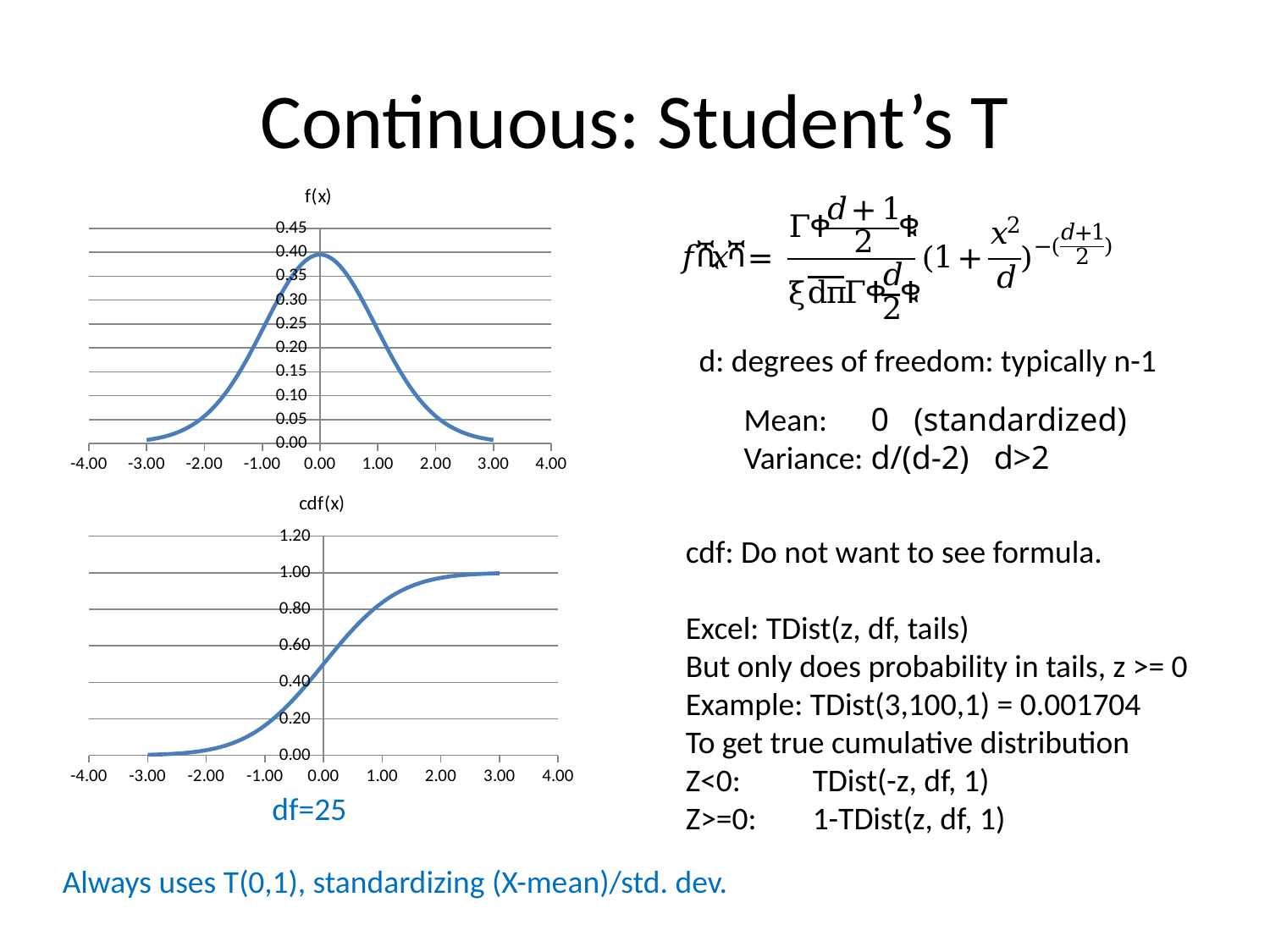
In the f(x) chart, is the value of the curve at x = 2.00 greater or less than 0.10? less In the cdf(x) chart, does the curve rise or fall as x increases from -3.00 to 3.00? rise What is the title of the bottom chart? cdf(x) In the f(x) chart, is the value of the curve at x = -1.00 greater or less than 0.20? greater What kind of chart is the bottom chart titled cdf(x)? line chart In the cdf(x) chart, is the value of the curve at x = 0.00 greater or less than 0.40? greater What kind of chart is the top chart titled f(x)? line chart What is the title of the top chart? f(x) In the f(x) chart, at which x value does the curve reach its highest point? 0.00